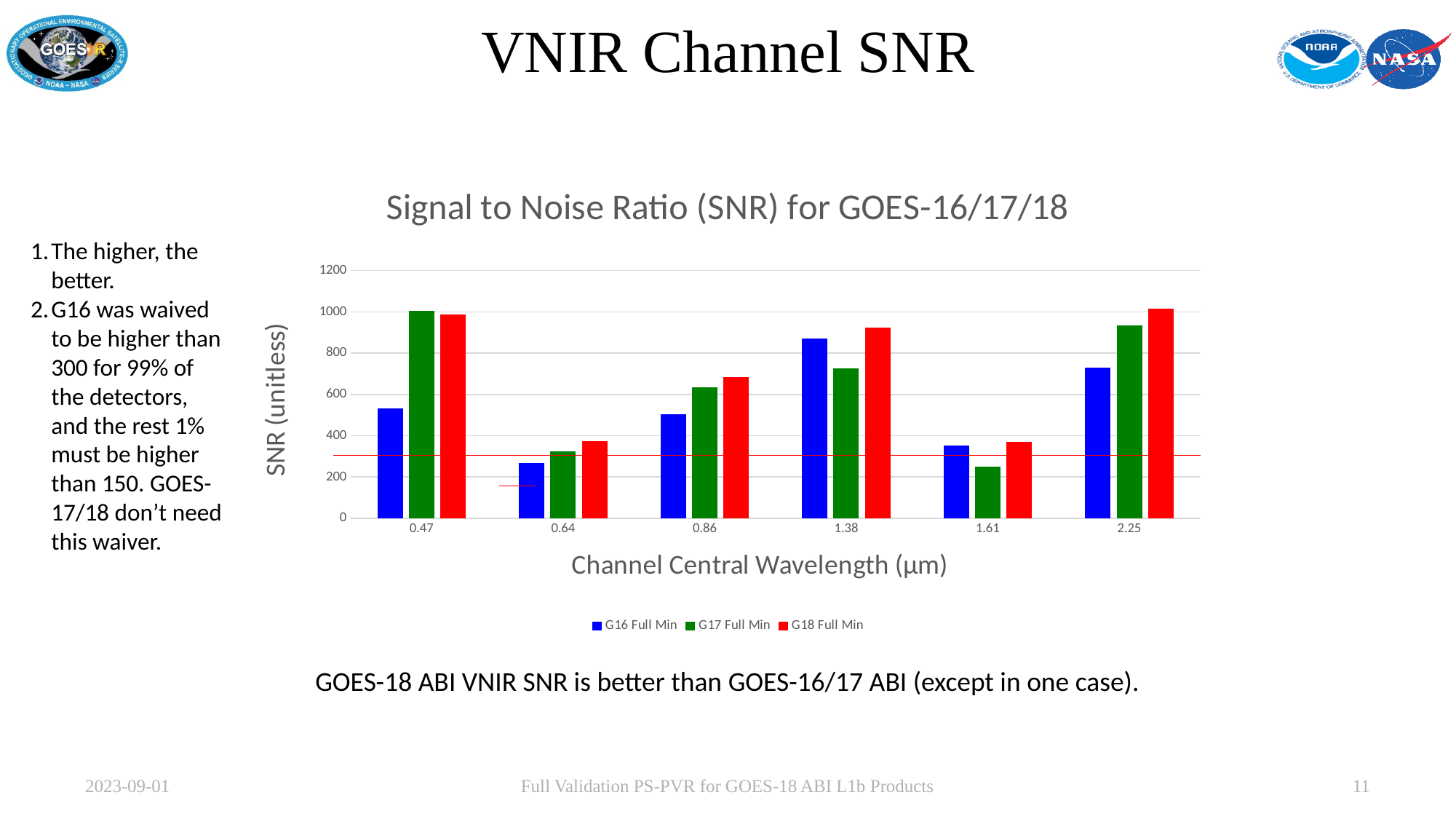
How many series does the legend list? 3 At 1.38 µm, which is larger: G16 Full Min or G17 Full Min? G16 Full Min What kind of chart is shown on the slide? Bar chart Is the G18 Full Min value at 0.86 µm greater or less than 600? greater Is the G17 Full Min value at 1.61 µm greater or less than 400? less At which channel central wavelength is the G16 Full Min value highest? 1.38 Is the G16 Full Min value at 0.47 µm greater or less than 600? less How many channel central wavelengths are shown on the x axis? 6 What is the title of the chart? Signal to Noise Ratio (SNR) for GOES-16/17/18 At 0.64 µm, which is larger: G16 Full Min or G18 Full Min? G18 Full Min At which channel central wavelength is the G17 Full Min value lowest? 1.61